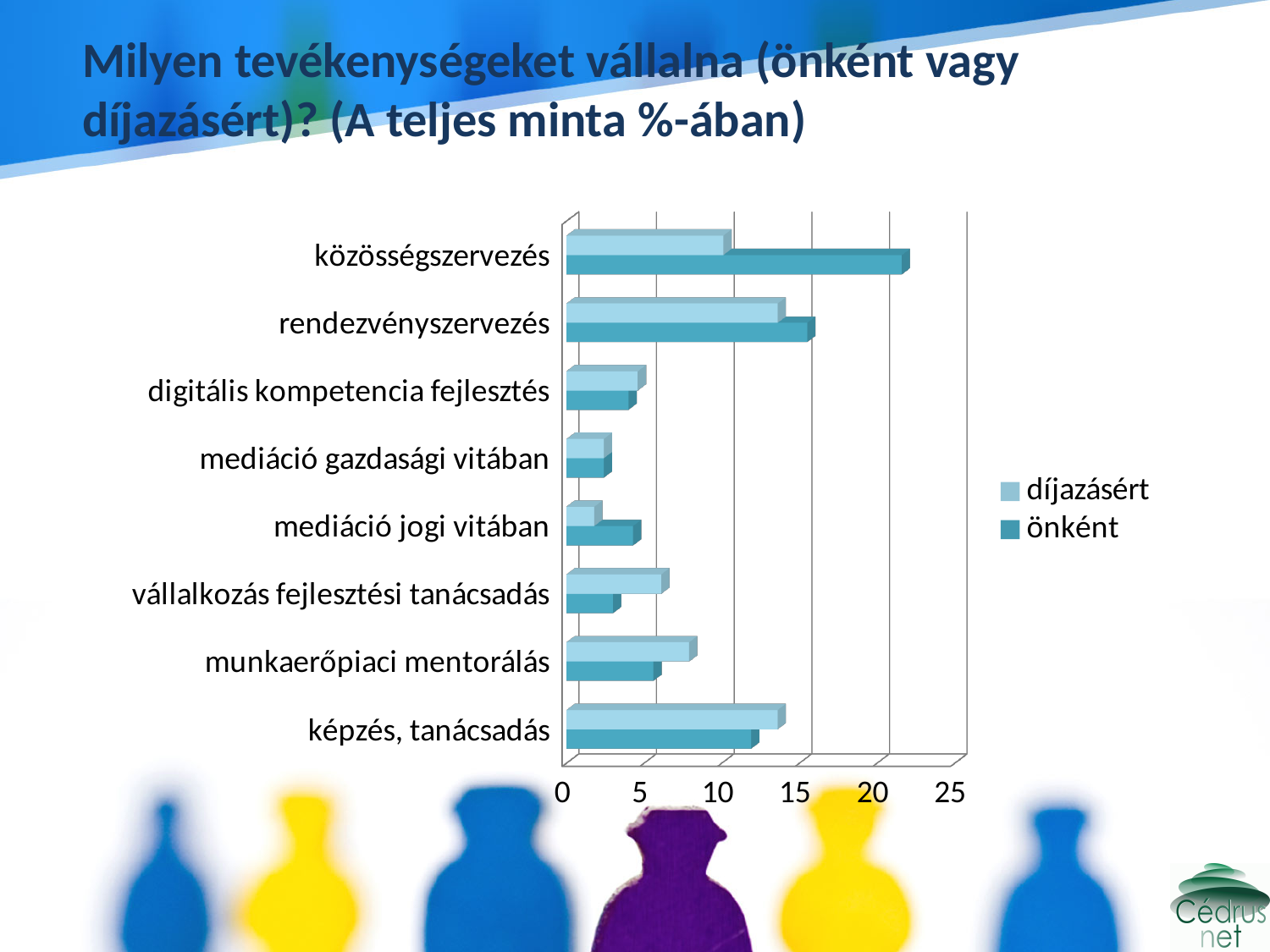
What kind of chart is shown on the slide? bar chart For közösségszervezés, which series has the larger value, díjazásért or önként? önként How many series does the legend list? 2 Is the önként value for közösségszervezés greater or less than 20? greater What are the two series names listed in the legend? díjazásért and önként Is the díjazásért value for képzés, tanácsadás greater or less than 10? greater How many activity categories are shown on the chart? 8 Which category has the highest value for the önként series? közösségszervezés Is the díjazásért value for mediáció gazdasági vitában greater or less than 5? less For vállalkozás fejlesztési tanácsadás, which series has the larger value, díjazásért or önként? díjazásért For mediáció jogi vitában, which series has the larger value, díjazásért or önként? önként